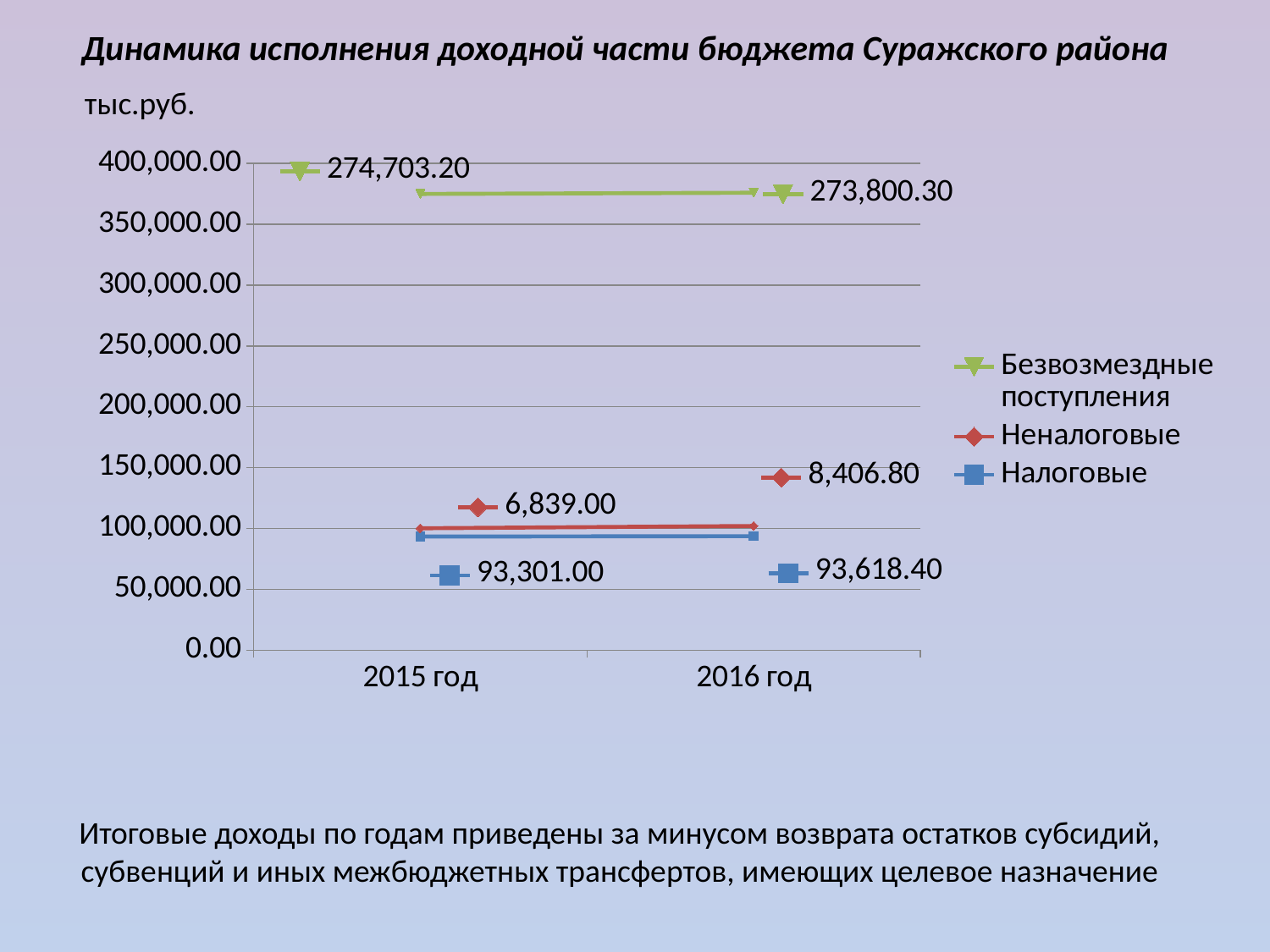
How many series does the legend list? 3 What is the value for Безвозмездные поступления in 2016 год? 273,800.30 By how much did Неналоговые change from 2015 год to 2016 год? 1,567.80 Which series has the lowest value in 2015 год? Неналоговые Which is larger: Безвозмездные поступления in 2015 год or in 2016 год? 2015 год What kind of chart is shown on the slide? line chart What is the value for Неналоговые in 2016 год? 8,406.80 Does the value for Налоговые rise or fall from 2015 год to 2016 год? rise What is the value for Безвозмездные поступления in 2015 год? 274,703.20 Which series has the highest value in 2016 год? Безвозмездные поступления What is the value for Неналоговые in 2015 год? 6,839.00 What is the value for Налоговые in 2016 год? 93,618.40